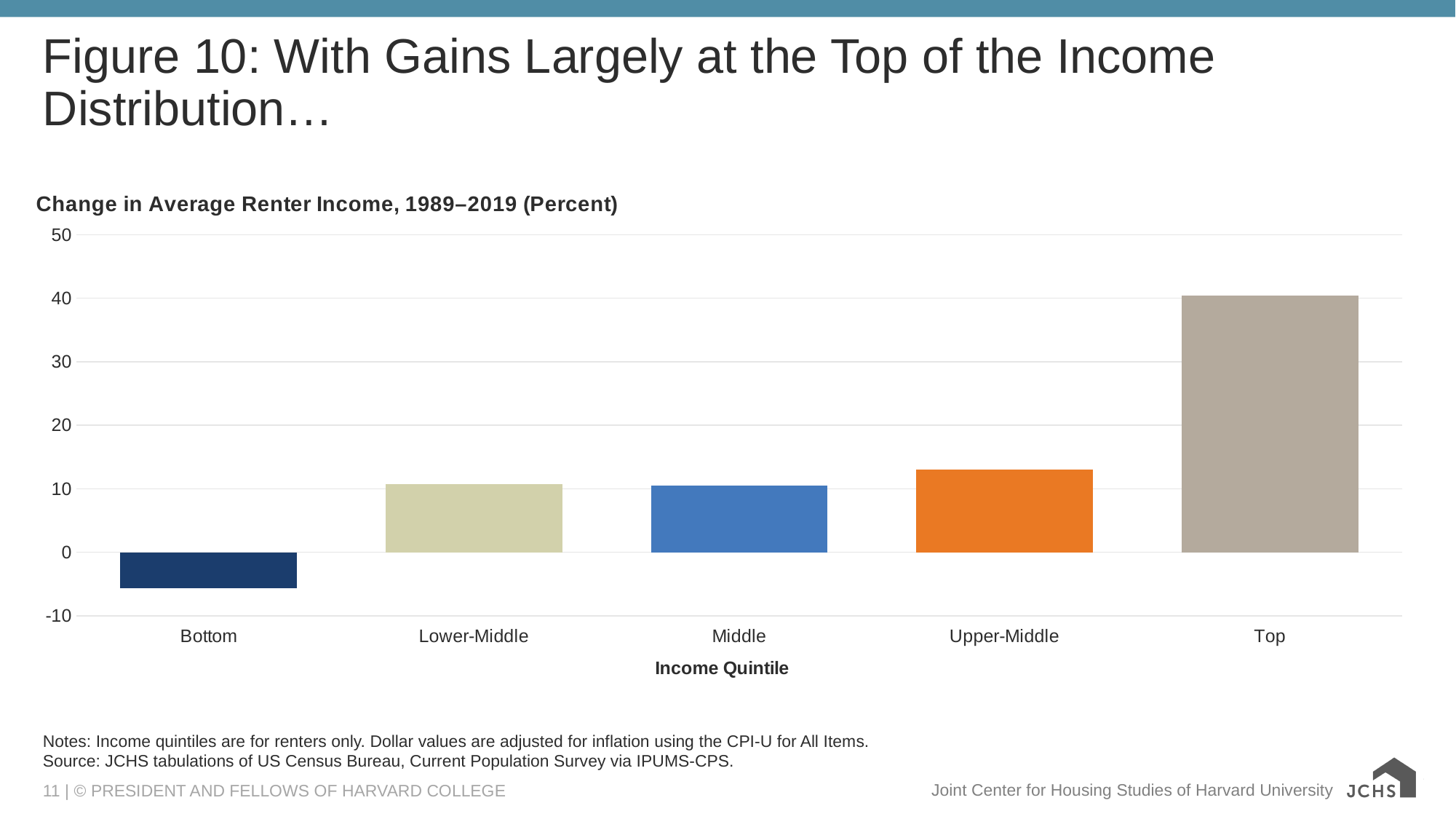
What is the title of the chart? Change in Average Renter Income, 1989–2019 (Percent) Which income quintile has the lowest change in average renter income? Bottom Is the value for the Top quintile greater or less than 50? less Is the value for the Upper-Middle quintile greater or less than 10? greater Is the value for the Bottom quintile greater or less than 0? less Which has a larger change in average renter income, the Upper-Middle quintile or the Bottom quintile? Upper-Middle Which has a larger change in average renter income, the Top quintile or the Bottom quintile? Top Do the values generally rise or fall moving from the Bottom quintile to the Top quintile? rise What kind of chart is shown on the slide? bar chart How many income quintiles are shown on the chart? 5 Which income quintile has the highest change in average renter income? Top